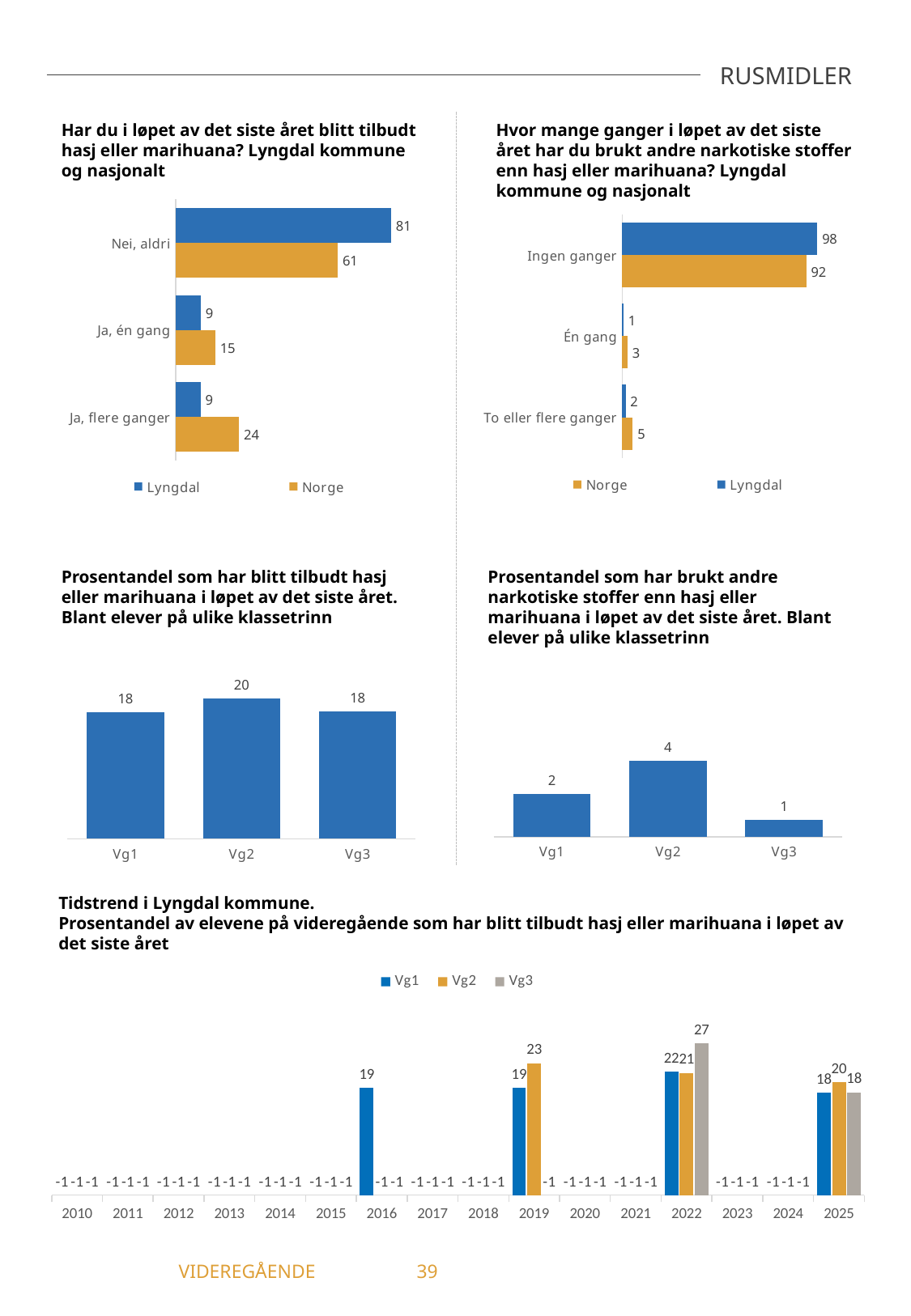
How many series does the legend of the top-right chart ("Hvor mange ganger i løpet av det siste året har du brukt andre narkotiske stoffer...") list? 2 In the top-left chart ("Har du i løpet av det siste året blitt tilbudt hasj eller marihuana?"), which is larger for "Ja, én gang": Lyngdal or Norge? Norge In the top-left chart ("Har du i løpet av det siste året blitt tilbudt hasj eller marihuana?"), what is the difference between the Norge and Lyngdal values for "Ja, flere ganger"? 15 In the top-right chart ("Hvor mange ganger i løpet av det siste året har du brukt andre narkotiske stoffer..."), what is the value for Lyngdal in the "To eller flere ganger" category? 2 In the bottom chart ("Tidstrend i Lyngdal kommune"), what is the value for Vg3 in 2022? 27 In the middle-right chart ("Prosentandel som har brukt andre narkotiske stoffer..."), which class level has the lowest value? Vg3 In the bottom chart ("Tidstrend i Lyngdal kommune"), what is the value for Vg2 in 2019? 23 In the middle-left chart ("Prosentandel som har blitt tilbudt hasj eller marihuana..."), which class level has the highest value? Vg2 In the top-right chart ("Hvor mange ganger i løpet av det siste året har du brukt andre narkotiske stoffer..."), what is the value for Norge in the "Ingen ganger" category? 92 In the top-left chart ("Har du i løpet av det siste året blitt tilbudt hasj eller marihuana?"), what is the value for Lyngdal in the "Nei, aldri" category? 81 In the middle-right chart ("Prosentandel som har brukt andre narkotiske stoffer..."), what is the value for Vg2? 4 What kind of chart is the bottom chart ("Tidstrend i Lyngdal kommune")? Bar chart